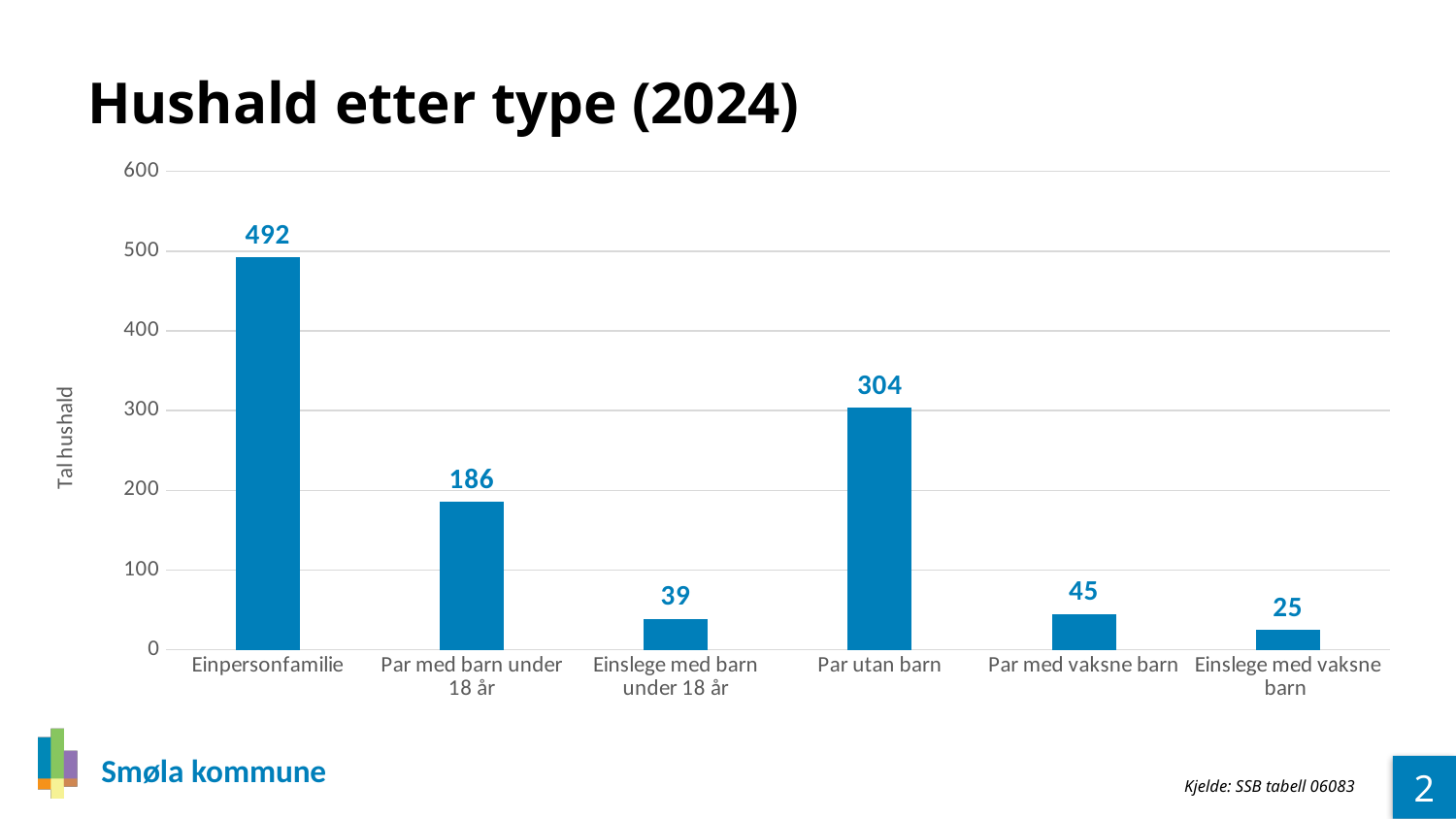
Which household type has the highest value? Einpersonfamilie What is the difference between the values for Par med vaksne barn and Einslege med barn under 18 år? 6 What is the title of the chart? Hushald etter type (2024) Which is larger, the value for Par med barn under 18 år or the value for Par utan barn? Par utan barn What is the value for Einpersonfamilie? 492 Is the value for Par med barn under 18 år greater or less than 200? less Which household type has the lowest value? Einslege med vaksne barn How many household types are shown on the chart? 6 What kind of chart is shown on the slide? bar chart What is the value for Einslege med vaksne barn? 25 What is the value for Par utan barn? 304 What is the difference between the values for Einpersonfamilie and Par utan barn? 188